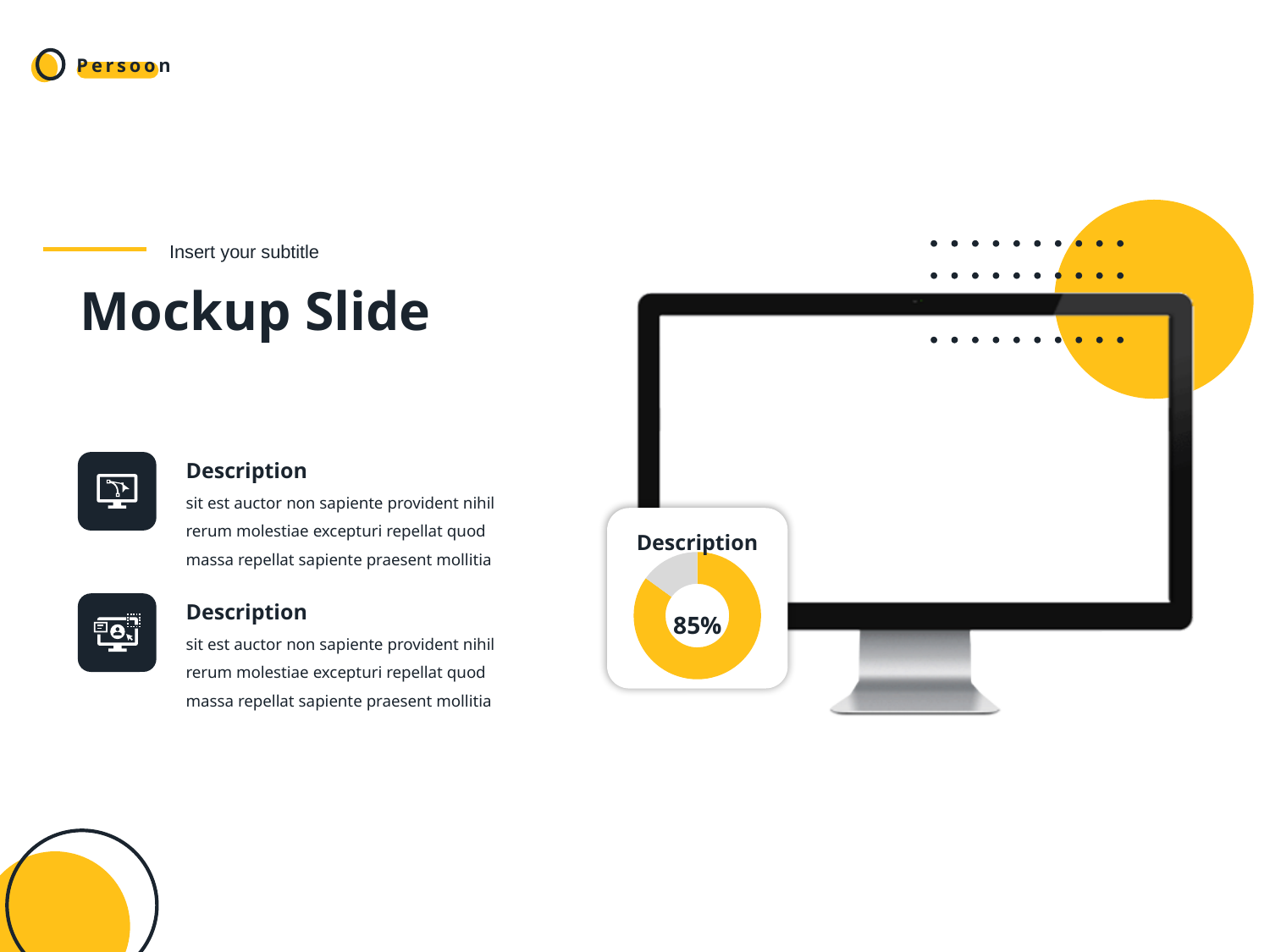
What kind of chart is shown on the slide? doughnut chart How many slices does the doughnut chart have? 2 What percentage is printed in the centre of the doughnut chart? 85% Is the value shown on the doughnut chart greater or less than 50%? greater What is the title shown above the doughnut chart? Description What colour is the larger slice of the doughnut chart? yellow Which slice of the doughnut chart is larger, the yellow one or the grey one? yellow